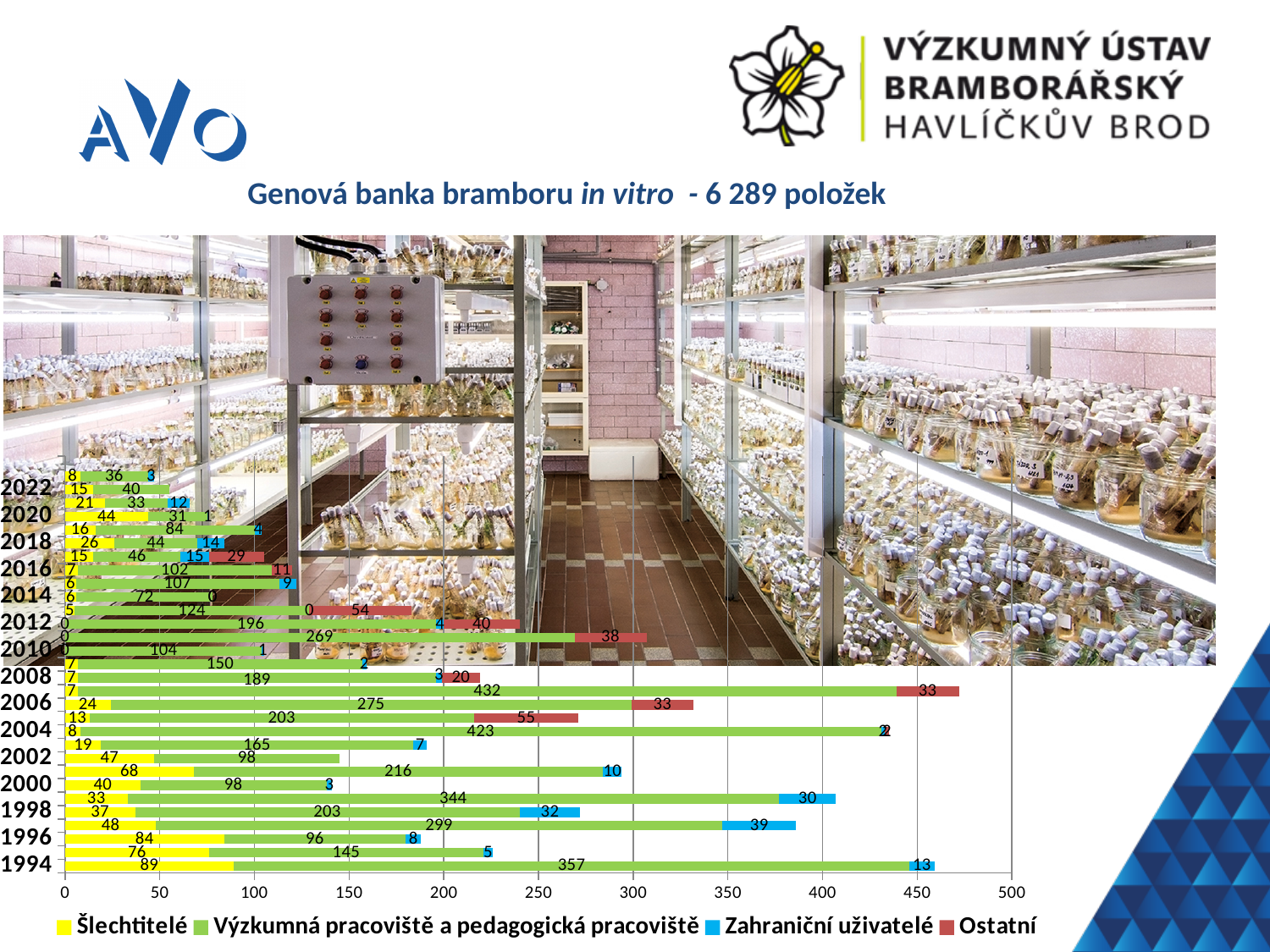
What type of chart is shown on the slide? Stacked bar chart What is the value for Zahraniční uživatelé in 2018? 14 How many series does the chart legend list? 4 What is the total of the stacked bar for 2008? 219 What is the value for Výzkumná pracoviště a pedagogická pracoviště in 1994? 357 What is the difference between the Výzkumná pracoviště a pedagogická pracoviště values for 2004 and 2006? 148 Which is larger, the Výzkumná pracoviště a pedagogická pracoviště value for 2004 or for 1994? 2004 What is the value for Ostatní in 2012? 40 What is the value for Šlechtitelé in 1994? 89 What is the total of the stacked bar for 2020? 76 Is the total bar length for 2006 greater or less than 300? greater Which colour represents Šlechtitelé in the legend? Yellow